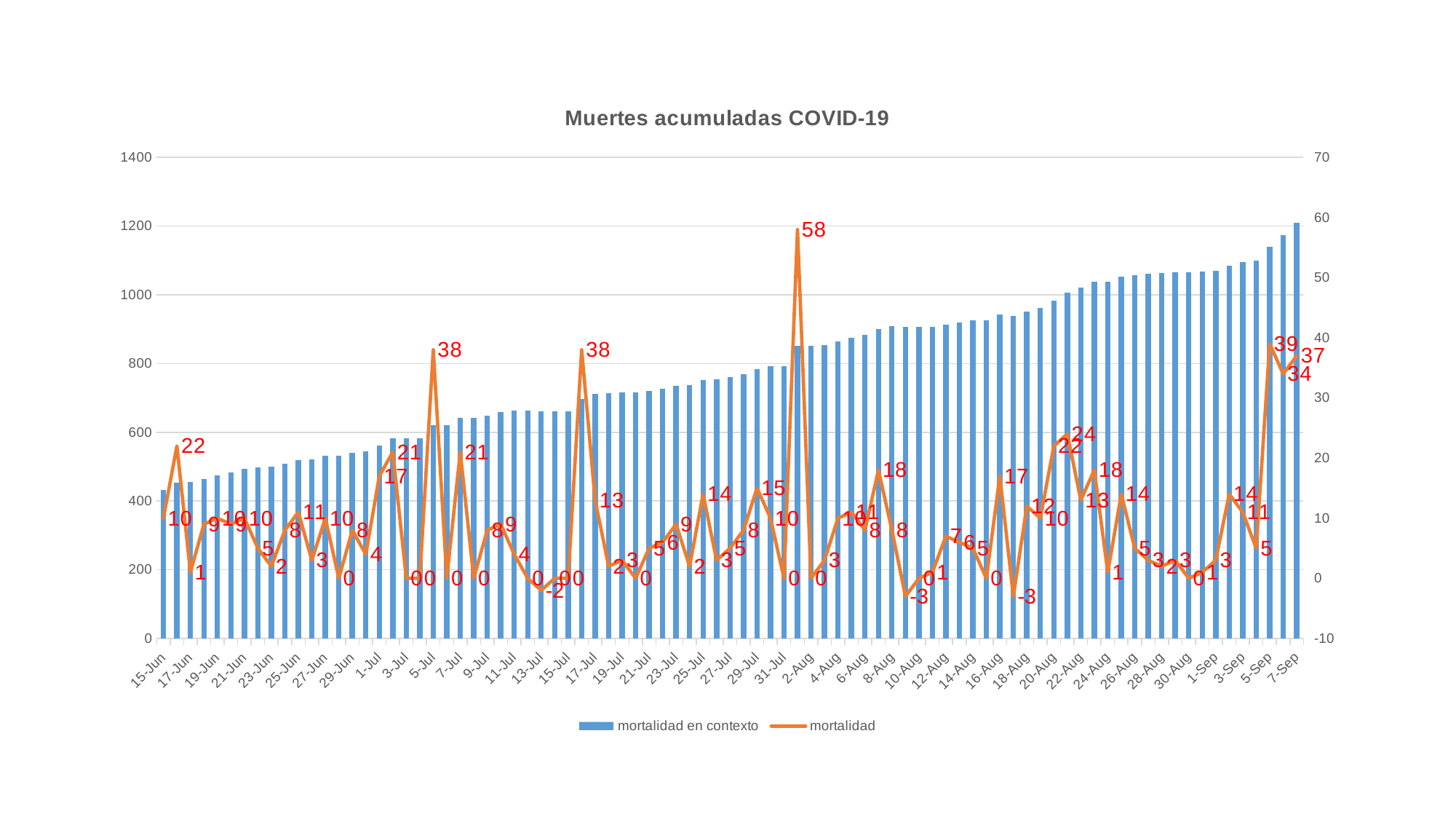
Do the mortalidad en contexto bars rise or fall from 15-Jun to 7-Sep? Rise What is the difference between the mortalidad peak on 1-Aug (58) and the peak on 5-Jul (38)? 20 Is the mortalidad en contexto bar for 7-Sep greater or less than 1000? greater What kind of chart is this? Combined bar and line chart What is the highest value shown on the mortalidad line? 58 On which date does the mortalidad line reach its highest value? 1-Aug Which series is drawn as bars? mortalidad en contexto How many series does the legend list? 2 What is the mortalidad value on 7-Sep? 37 What is the title of the chart? Muertes acumuladas COVID-19 Is the mortalidad en contexto bar for 15-Jun greater or less than 600? less Which is larger on the mortalidad line: the peak on 1-Aug or the peak on 5-Jul? 1-Aug